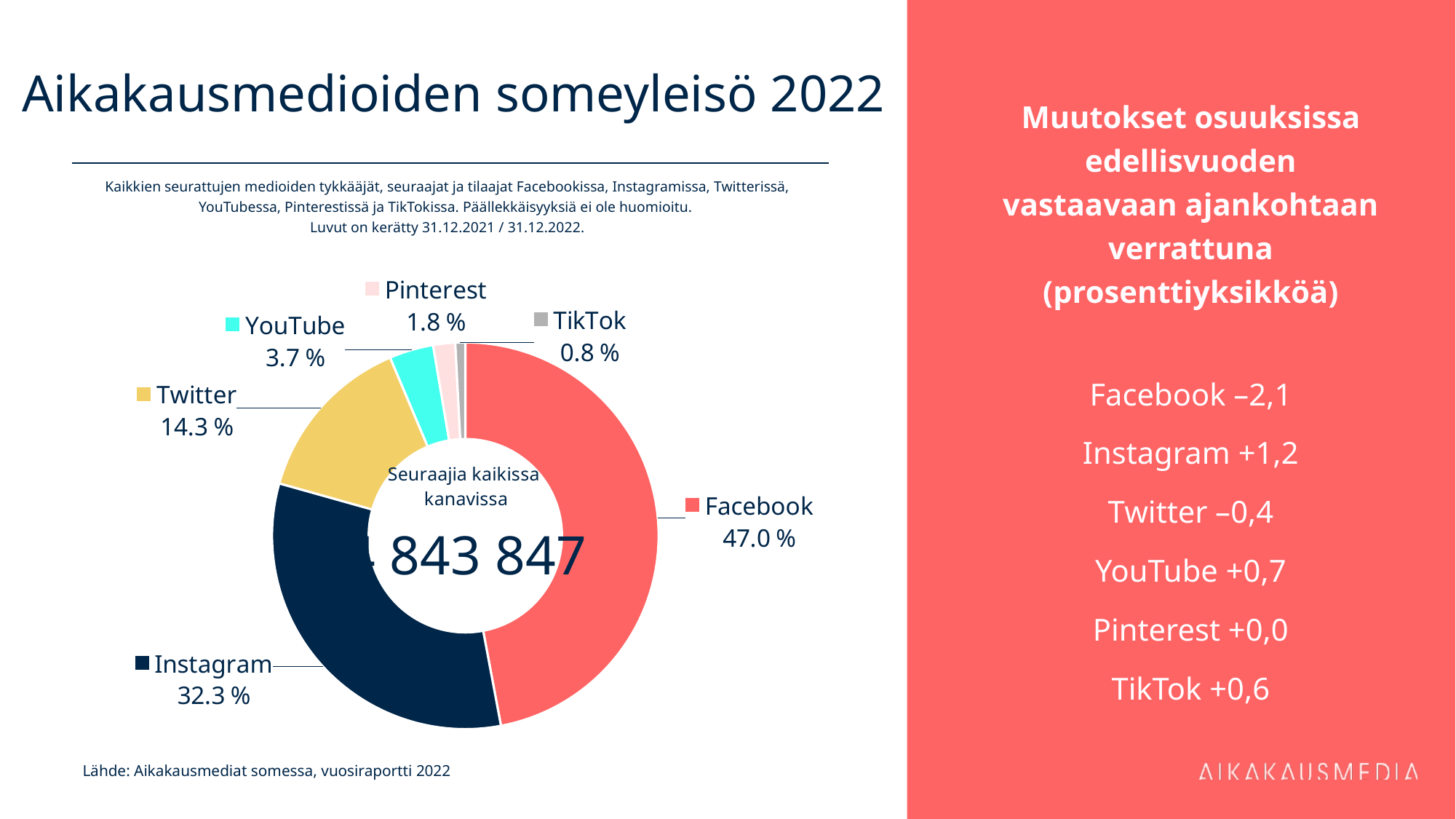
What is the value shown for Twitter? 14.3 % Which channel has the smallest share in the chart? TikTok What is the value shown for YouTube? 3.7 % What is the value shown for Pinterest? 1.8 % What share of the social media audience does Facebook have? 47.0 % What is the combined share of Facebook and Instagram? 79.3 % What kind of chart is shown on the slide? Pie chart (donut) What share does Instagram have in the chart? 32.3 % What is the difference in percentage points between Facebook's and Instagram's shares? 14.7 % How many channels (slices) are shown in the chart? 6 Which channel has the largest share in the chart? Facebook Which has a larger share, Twitter or YouTube? Twitter